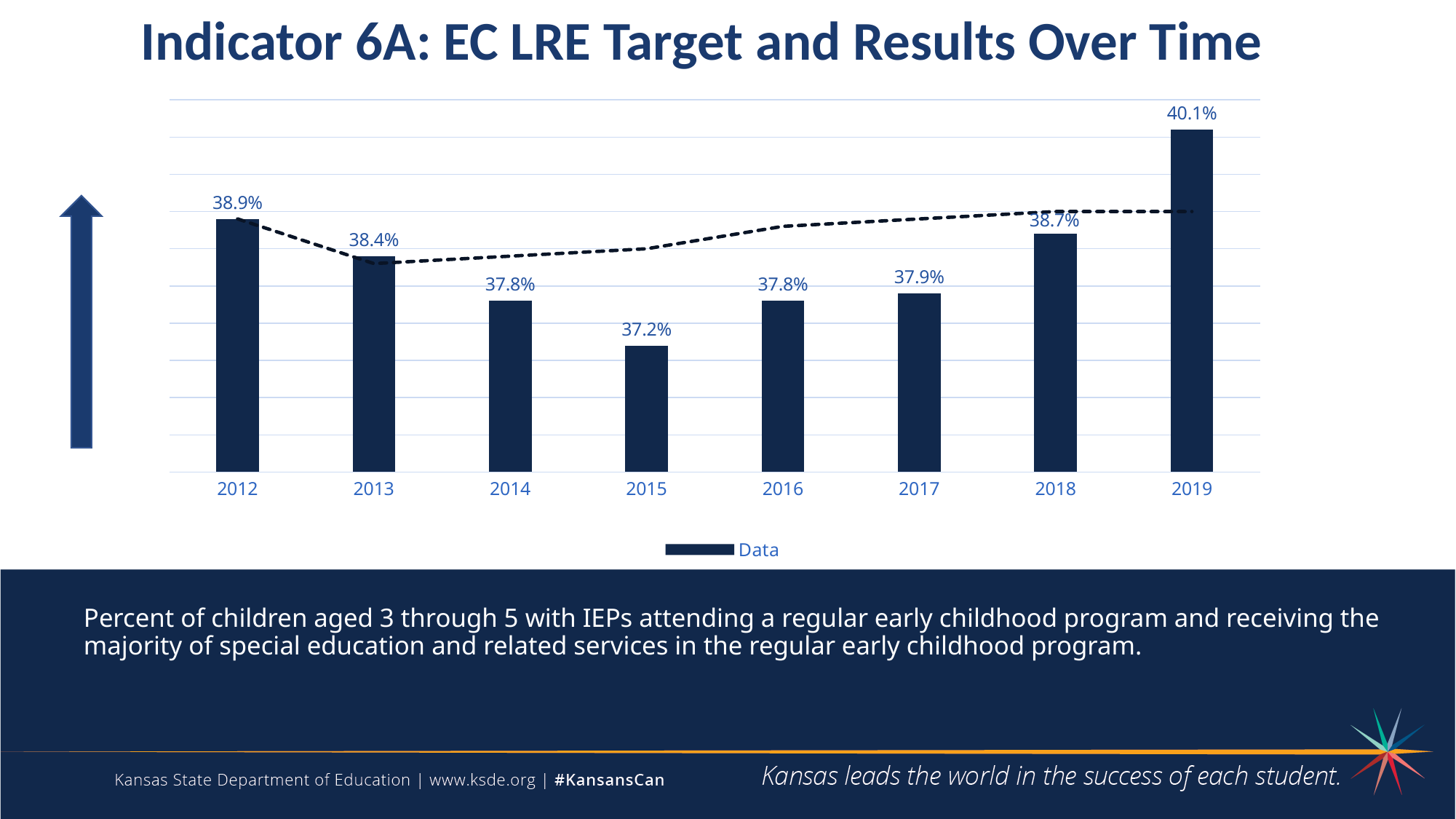
Do the values rise or fall from 2015 to 2019? rise What is the difference between the values for 2012 and 2015? 1.7% What is the value for 2013? 38.4% Which year has the highest value? 2019 What kind of chart is this? combination bar and line chart Which is larger, the value for 2012 or the value for 2018? 2012 What is the value for 2019? 40.1% How many years are shown on the x axis? 8 What is the title of the chart? Indicator 6A: EC LRE Target and Results Over Time What is the difference between the values for 2019 and 2018? 1.4% Which year has the lowest value? 2015 What is the value for 2015? 37.2%